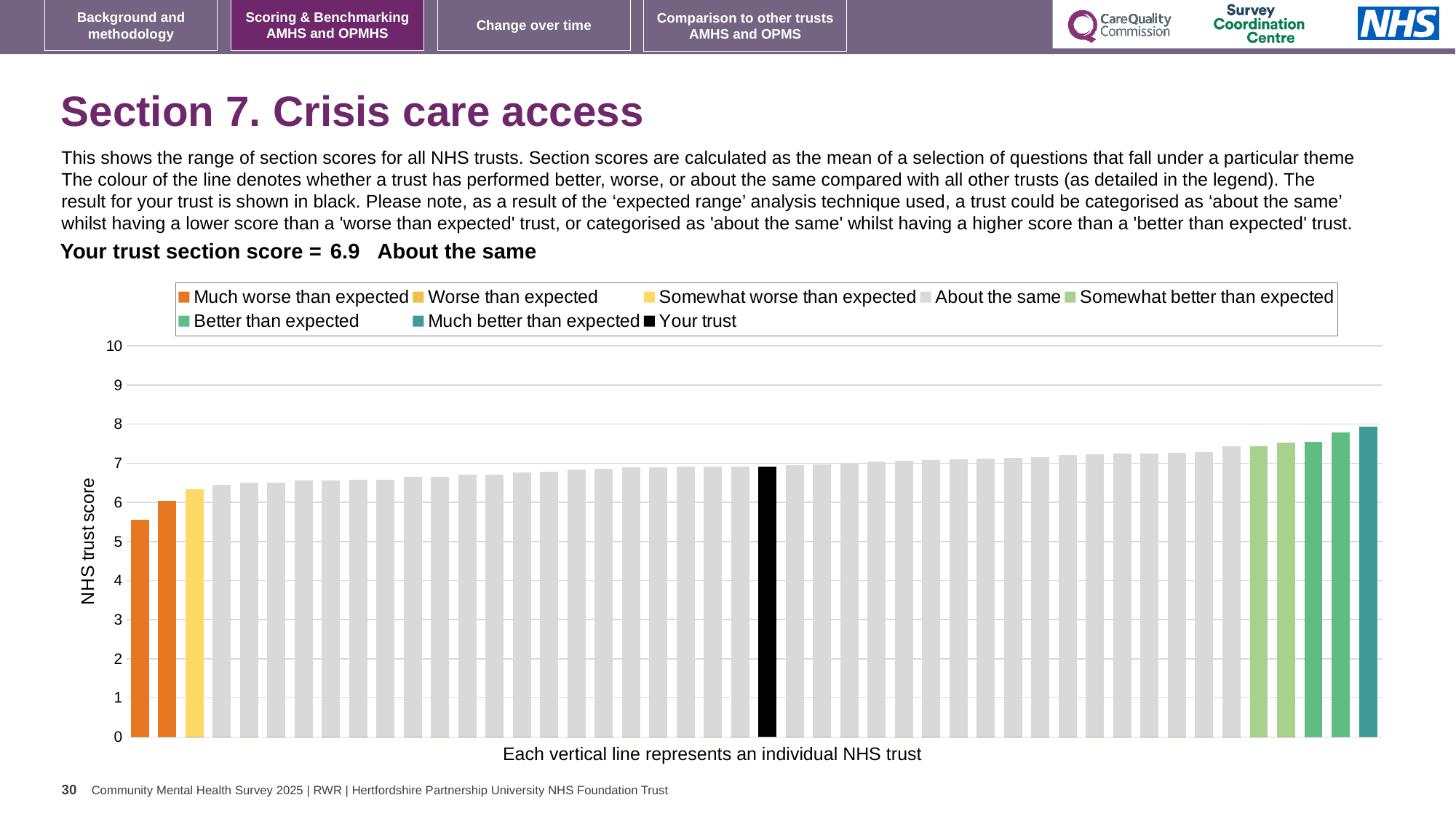
How many entries does the chart legend list? 8 What kind of chart is shown on the slide? bar chart Is the value of the lowest bar in the chart greater or less than 6? less How many bars are coloured orange for 'Much worse than expected'? 2 Is the value of the tallest bar in the chart greater or less than 7? greater Is the value of the black 'Your trust' bar greater or less than 6? greater What is the label on the vertical axis of the chart? NHS trust score Is the black 'Your trust' bar higher or lower than the teal 'Much better than expected' bar? lower How many bars are coloured teal for 'Much better than expected'? 1 What is the section score for your trust shown on the slide? 6.9 Which category is your trust placed in for Section 7 Crisis care access? About the same Do the bar values rise or fall from left to right along the x axis? rise